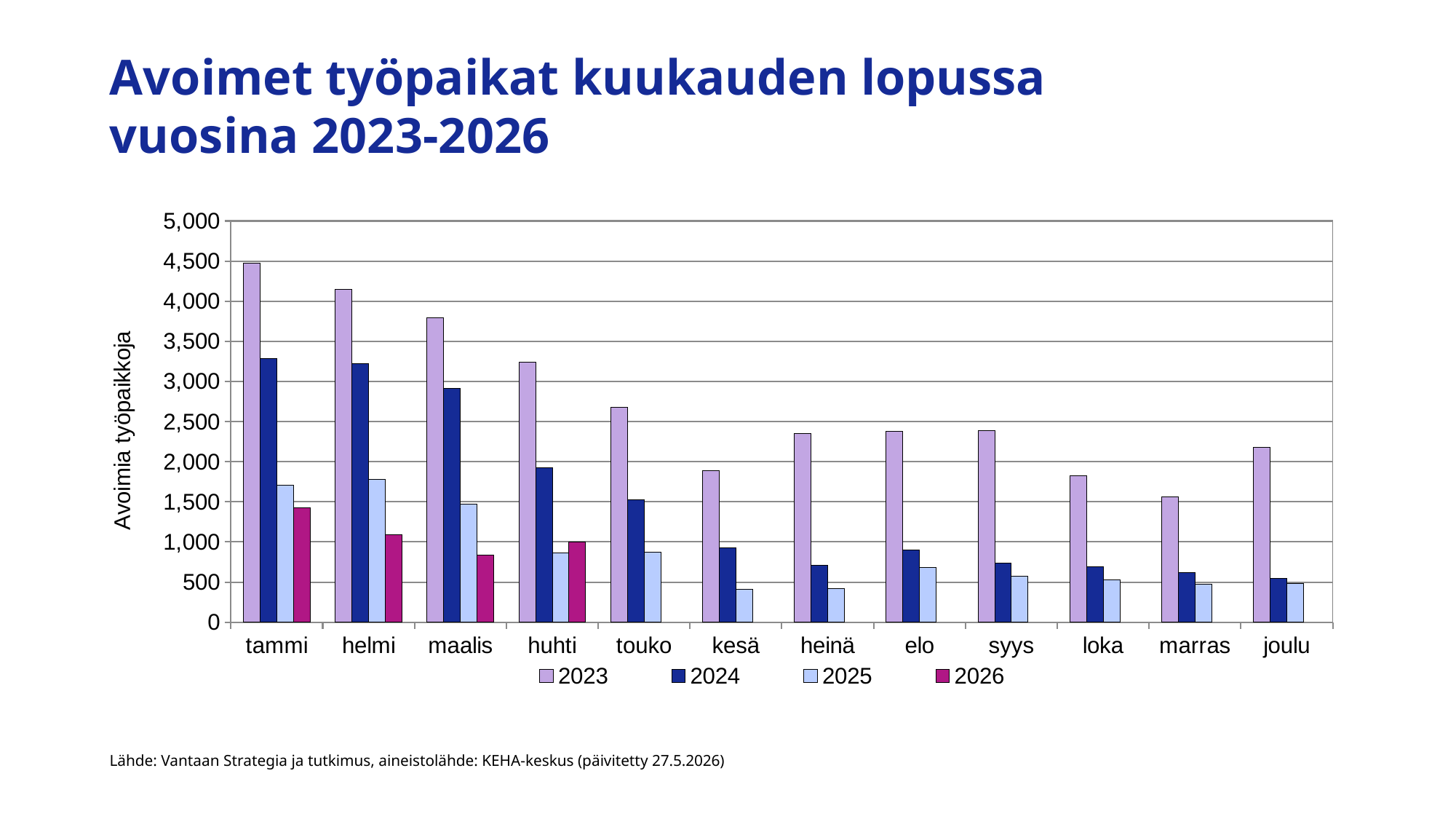
Is the value for tammi in 2023 greater or less than 4,000? greater For how many months is a 2026 bar plotted? 4 Which month has the lowest value for 2023? marras Is the value for huhti in 2024 greater or less than 2,000? less How many series does the legend list? 4 What kind of chart is shown on the slide? bar chart Is the value for kesä in 2025 greater or less than 500? less Which is larger for helmi: the 2023 value or the 2024 value? 2023 How many months are shown on the x axis? 12 Which month has the highest value for 2023? tammi Which month has the highest value for 2026? tammi